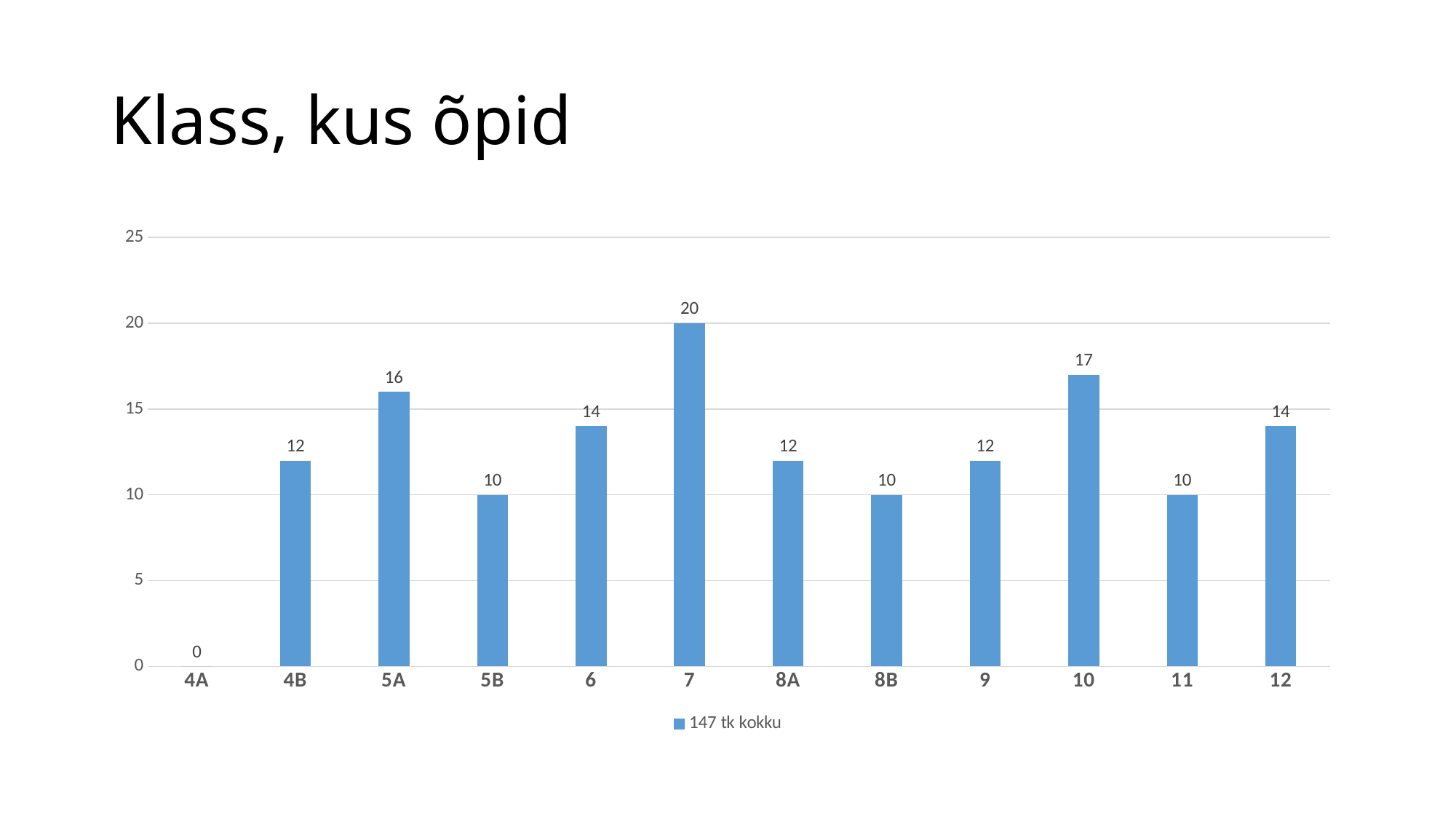
What is the value for class 7? 20 How many series does the legend list? 1 What is the legend entry for the series? 147 tk kokku How many classes are shown on the x axis? 12 Which class has the lowest value? 4A What kind of chart is shown on the slide? bar chart What is the difference between the values for class 7 and class 10? 3 What is the value for class 5A? 16 Is the value for class 10 greater or less than 15? greater Which is larger, the value for class 6 or the value for class 8B? 6 What is the value for class 4A? 0 Which class has the highest value? 7